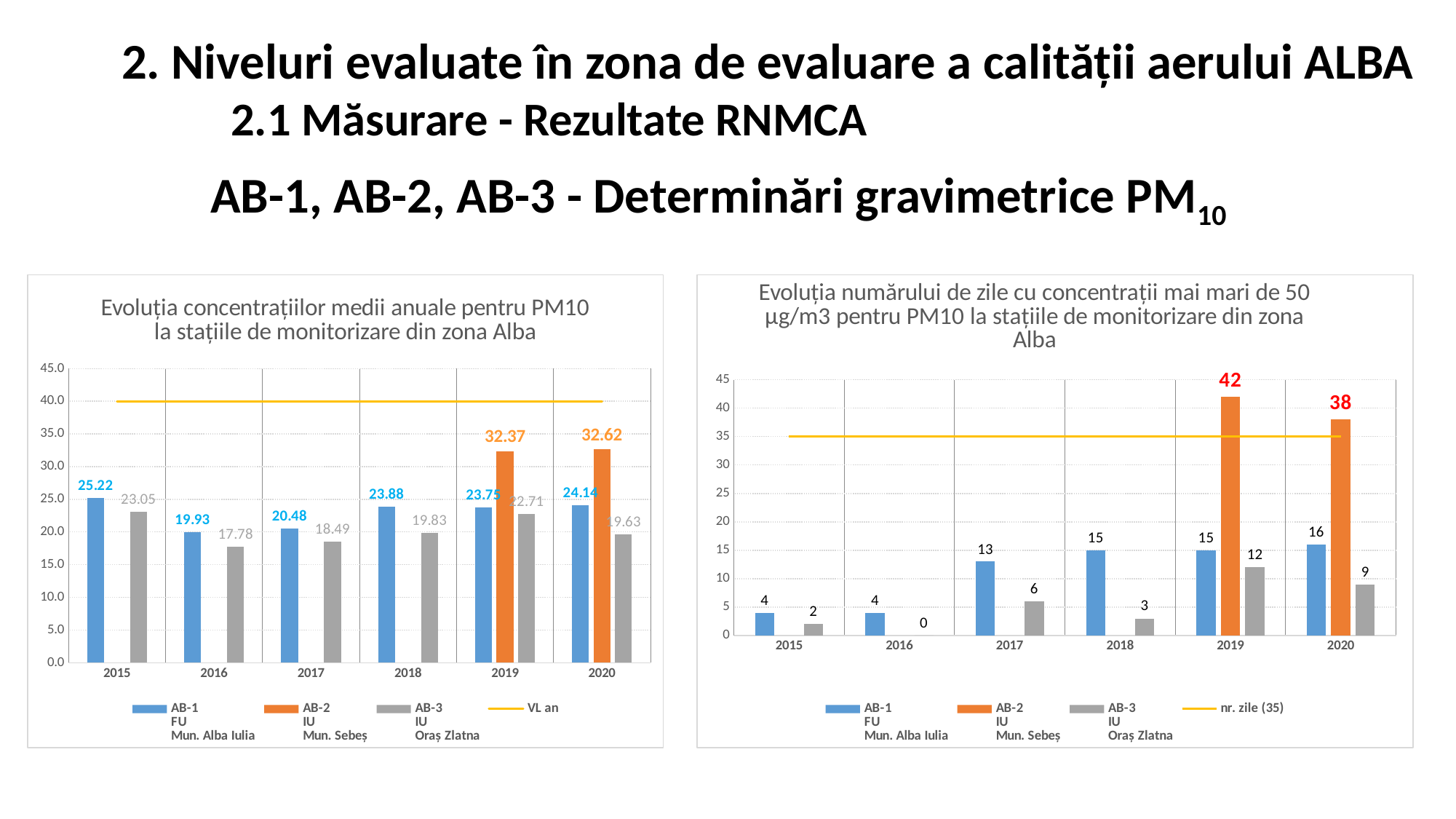
In the right chart (Evoluția numărului de zile cu concentrații mai mari de 50 µg/m3), which is larger in 2019: AB-1 or AB-3? AB-1 How many entries does the legend of the right chart list? 4 In the left chart (Evoluția concentrațiilor medii anuale pentru PM10), what is the difference between the AB-1 and AB-3 values in 2018? 4.05 In the left chart (Evoluția concentrațiilor medii anuale pentru PM10), which year has the lowest AB-1 value? 2016 In the right chart (Evoluția numărului de zile cu concentrații mai mari de 50 µg/m3), what is the difference between the AB-2 values in 2019 and 2020? 4 In the left chart (Evoluția concentrațiilor medii anuale pentru PM10), what is the value for AB-1 in 2015? 25.22 In the left chart (Evoluția concentrațiilor medii anuale pentru PM10), what is the value for AB-2 in 2020? 32.62 In the left chart (Evoluția concentrațiilor medii anuale pentru PM10), what is the value for AB-3 in 2016? 17.78 In the right chart (Evoluția numărului de zile cu concentrații mai mari de 50 µg/m3), what is the value for AB-3 in 2016? 0 In the left chart (Evoluția concentrațiilor medii anuale pentru PM10), how many years are shown on the x axis? 6 In the right chart (Evoluția numărului de zile cu concentrații mai mari de 50 µg/m3), what is the value for AB-2 in 2019? 42 In the right chart (Evoluția numărului de zile cu concentrații mai mari de 50 µg/m3), which year has the highest AB-1 value? 2020